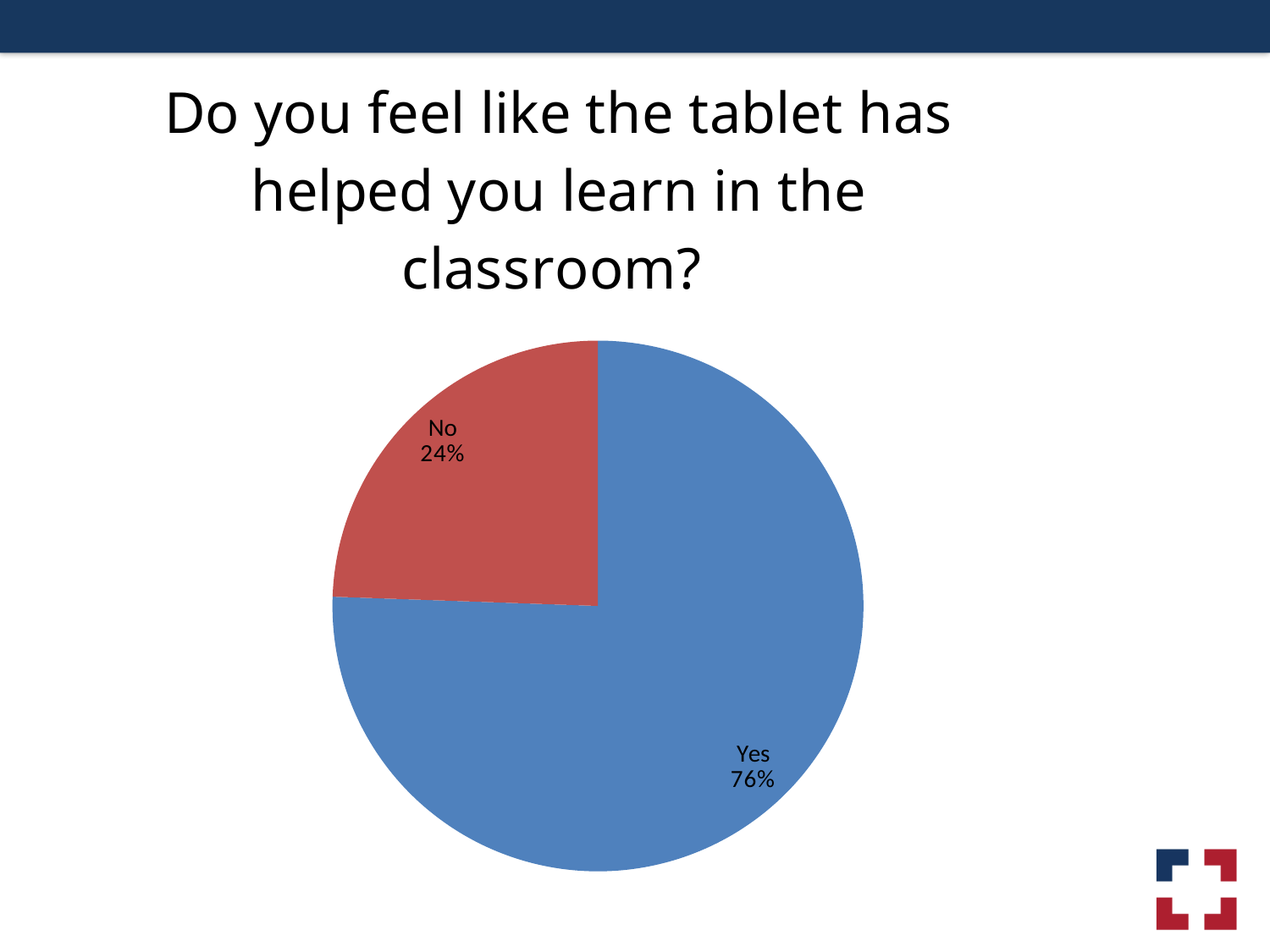
What percentage of respondents answered Yes? 76% What percentage of respondents answered No? 24% What question does the chart title ask? Do you feel like the tablet has helped you learn in the classroom? What colour is the Yes slice? blue Which response has the smallest share of the pie? No Which slice is larger, Yes or No? Yes What is the difference in percentage points between the Yes and No slices? 52 How many slices does the pie chart have? 2 Which response has the largest share of the pie? Yes What share of the pie does the No slice represent? 24% What kind of chart is shown on the slide? pie chart